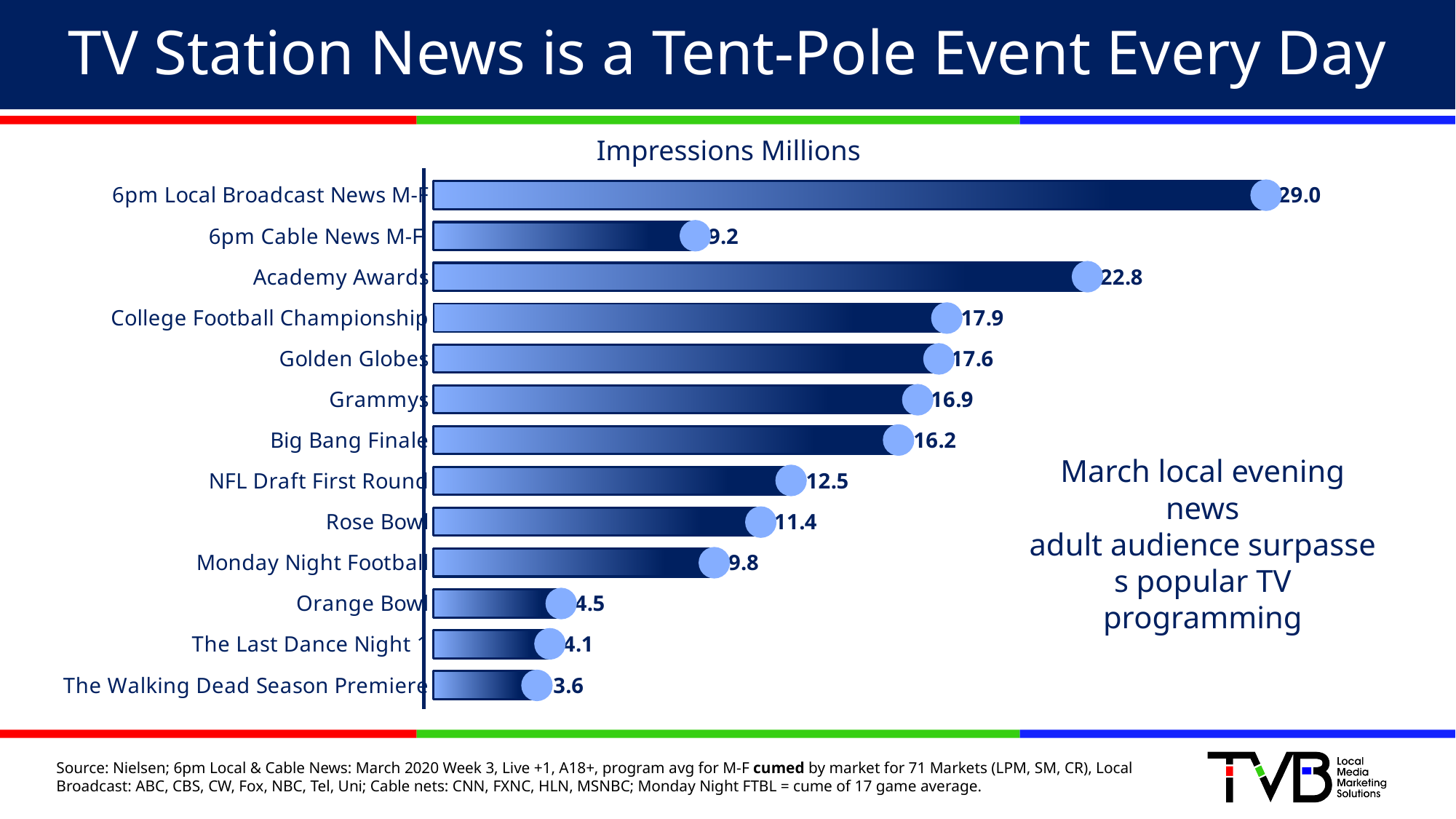
Which is larger, Rose Bowl or NFL Draft First Round? NFL Draft First Round Which category has the lowest value? The Walking Dead Season Premiere What is the difference between 6pm Local Broadcast News M-F and 6pm Cable News M-F? 19.8 Which category has the highest value? 6pm Local Broadcast News M-F Which is larger, Orange Bowl or The Last Dance Night 1? Orange Bowl What is the difference between Academy Awards and Grammys? 5.9 How many categories are shown in the chart? 13 What is the value for Academy Awards? 22.8 What is the title of the chart? Impressions Millions What is the value for 6pm Local Broadcast News M-F? 29.0 What is the value for Monday Night Football? 9.8 What kind of chart is shown on the slide? Bar chart